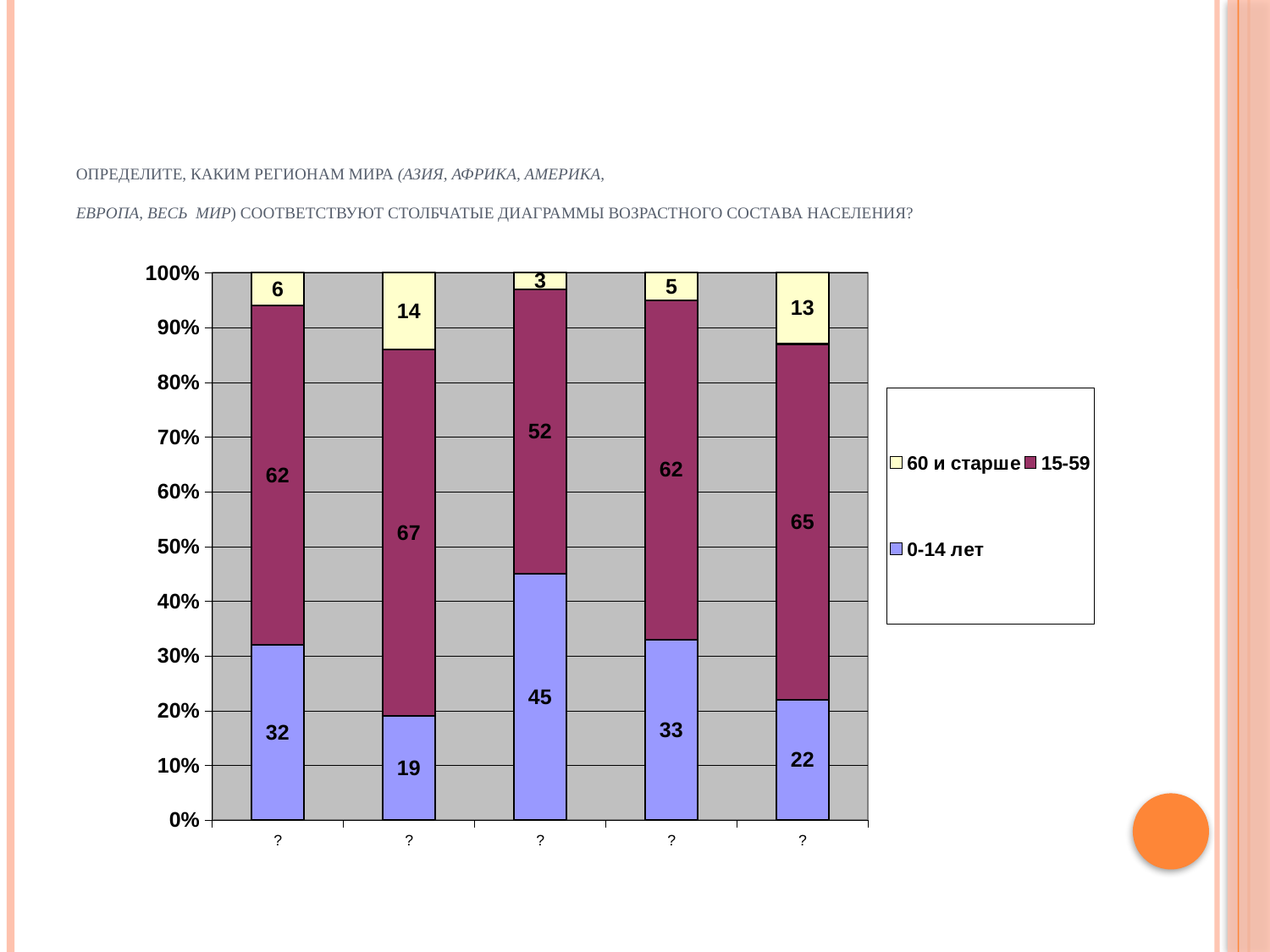
What are the three legend entries of the chart? 60 и старше, 15-59, 0-14 лет Which bar has the highest "0-14 лет" value? the middle (third) bar Which is larger: the "60 и старше" value of the second bar or of the rightmost bar? the second bar How many series does the legend list? 3 What kind of chart is shown on the slide? stacked bar chart What is the value of the "15-59" segment in the middle (third) bar? 52 What is the value of the "0-14 лет" segment in the rightmost bar? 22 How many bars are plotted in the chart? 5 Which bar has the lowest "60 и старше" value? the middle (third) bar What is the difference between the "15-59" values of the second bar and the middle (third) bar? 15 What is the value of the "0-14 лет" segment in the leftmost bar? 32 What is the value of the "60 и старше" segment in the second bar from the left? 14